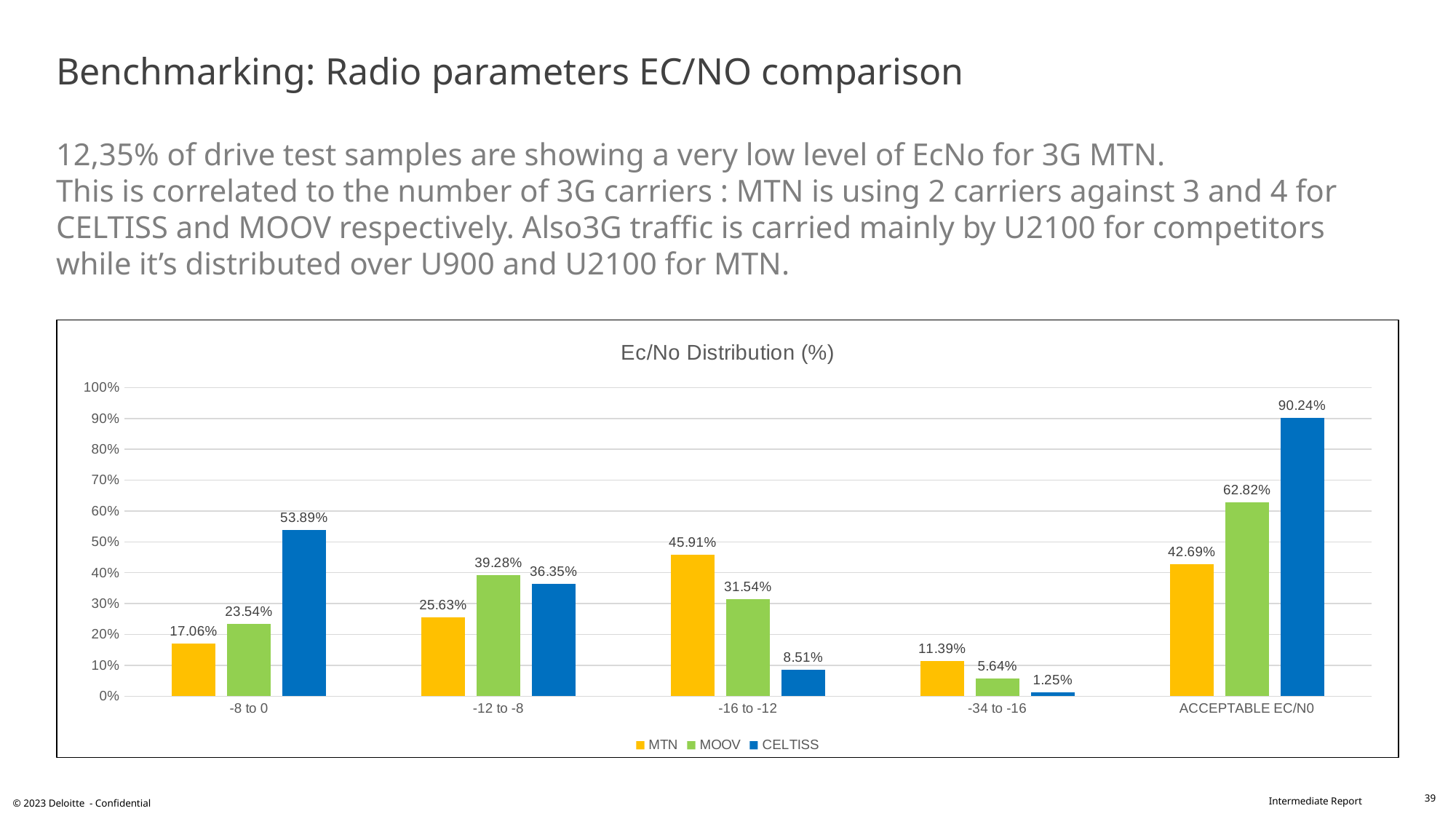
Which series has the lowest value in the -34 to -16 category? CELTISS What is the value for MOOV in the -12 to -8 category? 39.28% Is the value for MOOV in the ACCEPTABLE EC/N0 category greater or less than 60%? greater Which is larger in the -12 to -8 category, the MOOV value or the CELTISS value? MOOV What is the difference between the CELTISS and MTN values in the ACCEPTABLE EC/N0 category? 47.55% What kind of chart is shown on the slide? Bar chart What is the value for MTN in the -16 to -12 category? 45.91% How many series does the legend list? 3 What is the value for CELTISS in the ACCEPTABLE EC/N0 category? 90.24% How many categories are shown on the x axis? 5 Which series has the highest value in the -8 to 0 category? CELTISS What is the title of the chart? Ec/No Distribution (%)